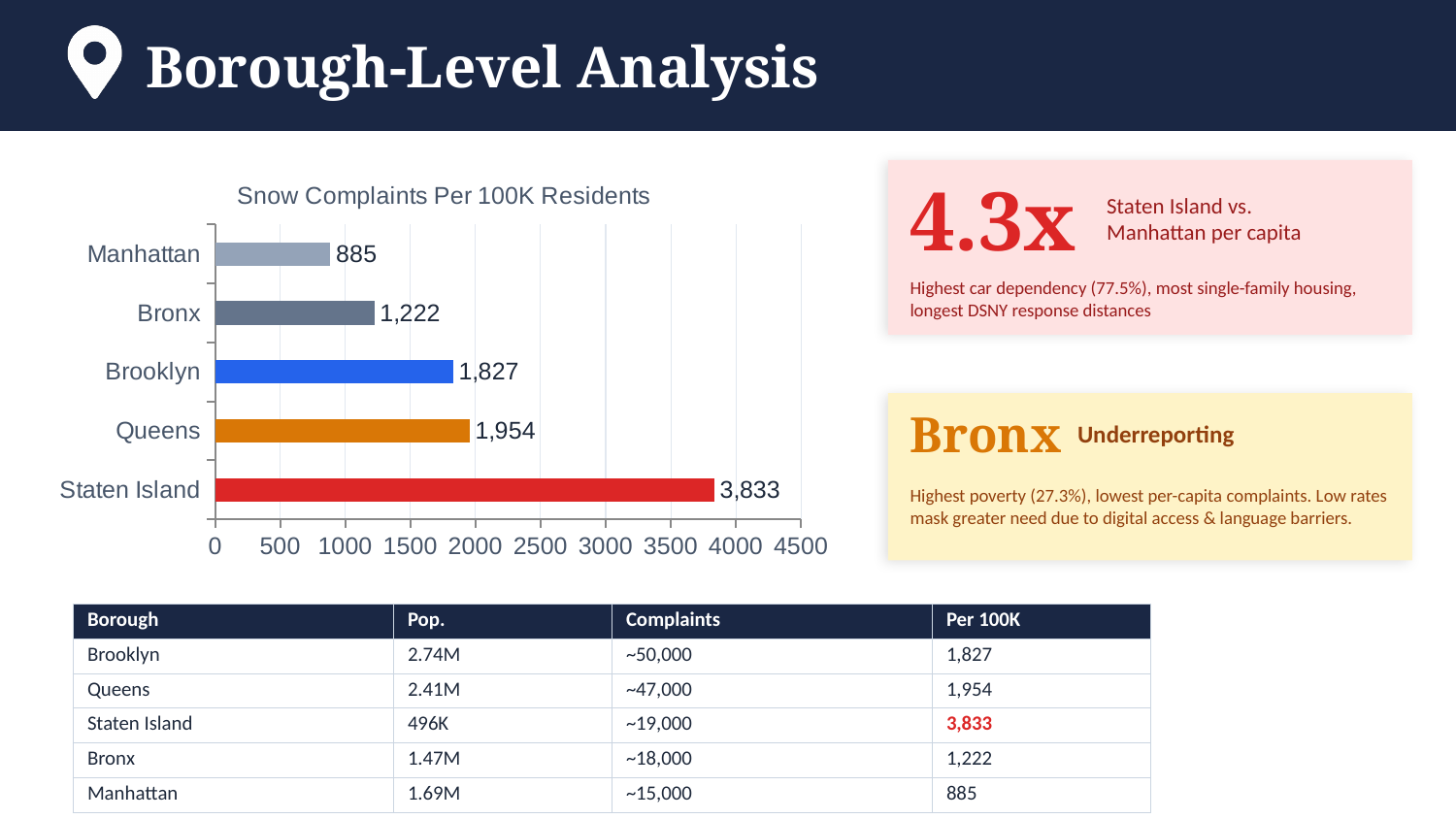
How many boroughs are shown in the chart? 5 What is the value for Queens in the chart? 1,954 Which has a larger value, Bronx or Brooklyn? Brooklyn What is the difference between the values for Queens and Brooklyn? 127 Which borough has the lowest snow complaints per 100K residents? Manhattan What is the value for Manhattan in the chart? 885 What kind of chart is shown on the slide? bar chart Is the value for Bronx greater or less than 1500? less What is the value for Staten Island in the Snow Complaints Per 100K Residents chart? 3,833 What is the title of the chart? Snow Complaints Per 100K Residents What is the difference between the values for Staten Island and Manhattan? 2,948 Which borough has the highest snow complaints per 100K residents? Staten Island